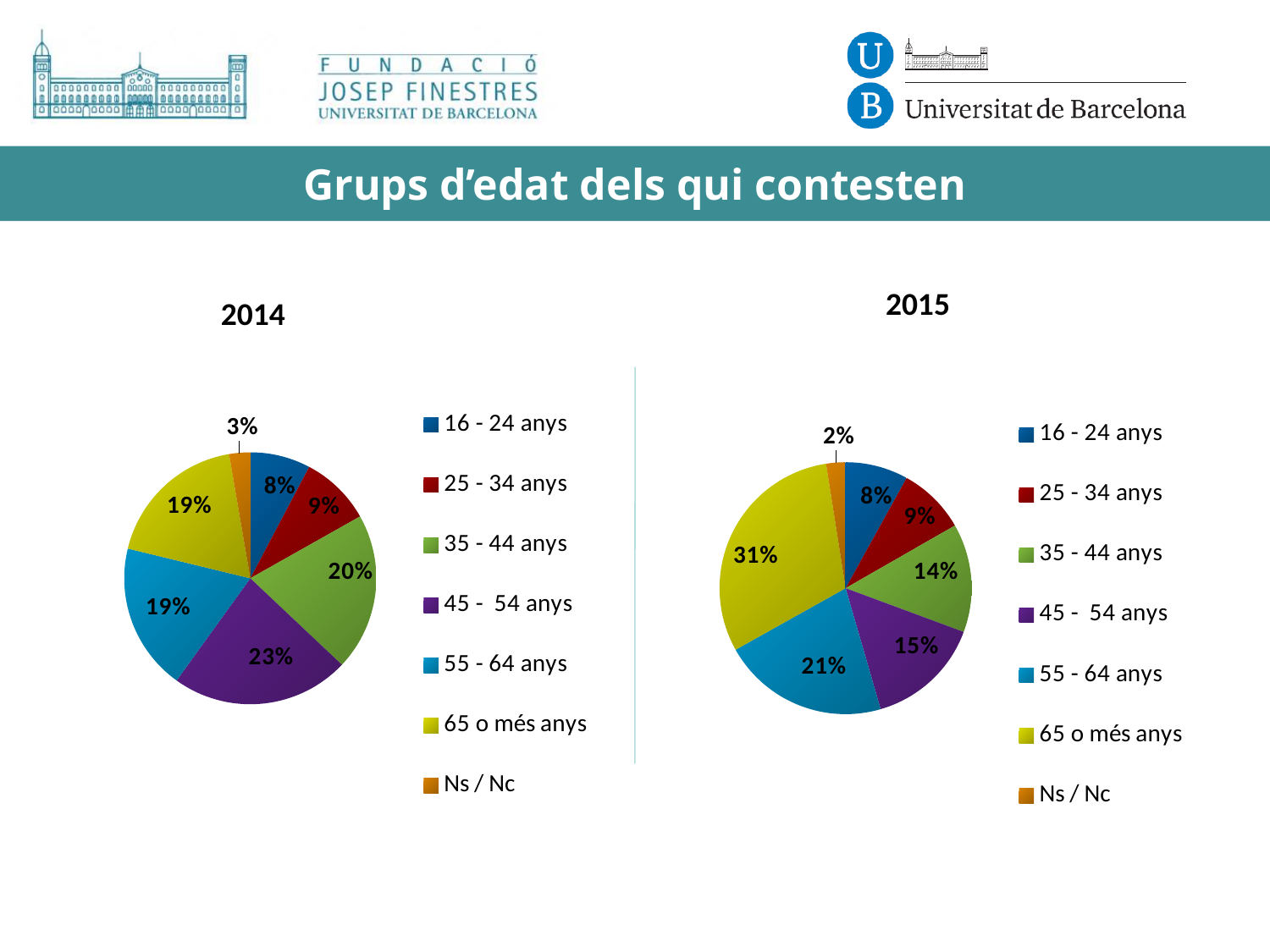
How many categories does the legend of the 2015 pie chart list? 7 What type of chart is used for the 2014 data? Pie chart In the 2014 pie chart, what is the combined share of the 55 - 64 anys and 65 o més anys groups? 38% In the 2015 pie chart, what percentage is shown for the 35 - 44 anys group? 14% In the 2014 pie chart, which age group has the largest share? 45 - 54 anys What is the title of the slide containing the two pie charts? Grups d'edat dels qui contesten In the 2015 pie chart, what is the difference between the 65 o més anys share and the 55 - 64 anys share? 10% In the 2014 pie chart, what percentage is shown for the 45 - 54 anys group? 23% In the 2015 pie chart, which category has the smallest share? Ns / Nc In the 2014 pie chart, what percentage is shown for Ns / Nc? 3% In the 2015 pie chart, what percentage is shown for the 65 o més anys group? 31% In the 2014 pie chart, which is larger: the share for 35 - 44 anys or the share for 55 - 64 anys? 35 - 44 anys